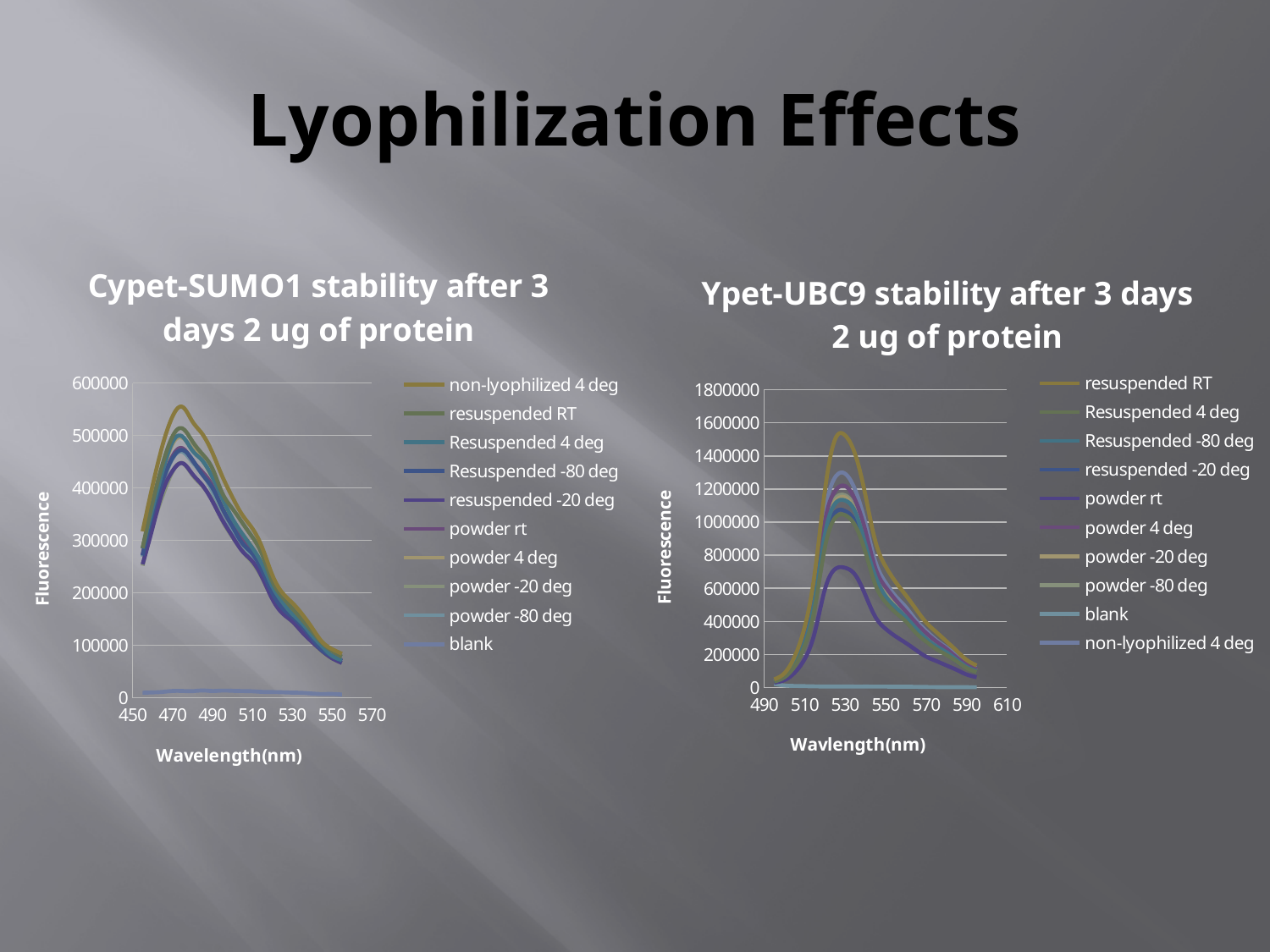
In the "Cypet-SUMO1 stability after 3 days 2 ug of protein" chart, do the fluorescence values rise or fall between 490 and 550 nm? fall In the "Cypet-SUMO1 stability after 3 days 2 ug of protein" chart, is the value for blank greater or less than 100000? less In the "Ypet-UBC9 stability after 3 days 2 ug of protein" chart, is the value for blank greater or less than 200000? less In the "Ypet-UBC9 stability after 3 days 2 ug of protein" chart, do the fluorescence values rise or fall between 550 and 590 nm? fall How many series does the legend of the "Cypet-SUMO1 stability after 3 days 2 ug of protein" chart list? 10 In the "Cypet-SUMO1 stability after 3 days 2 ug of protein" chart, which series has the lowest fluorescence across the wavelength range? blank In the "Cypet-SUMO1 stability after 3 days 2 ug of protein" chart, is the peak value of the highest series greater or less than 500000? greater What kind of chart is the "Cypet-SUMO1 stability after 3 days 2 ug of protein" chart? line chart How many series does the legend of the "Ypet-UBC9 stability after 3 days 2 ug of protein" chart list? 10 What is the highest value shown on the y axis of the "Ypet-UBC9 stability after 3 days 2 ug of protein" chart? 1800000 What is the x-axis label of the "Cypet-SUMO1 stability after 3 days 2 ug of protein" chart? Wavelength(nm)